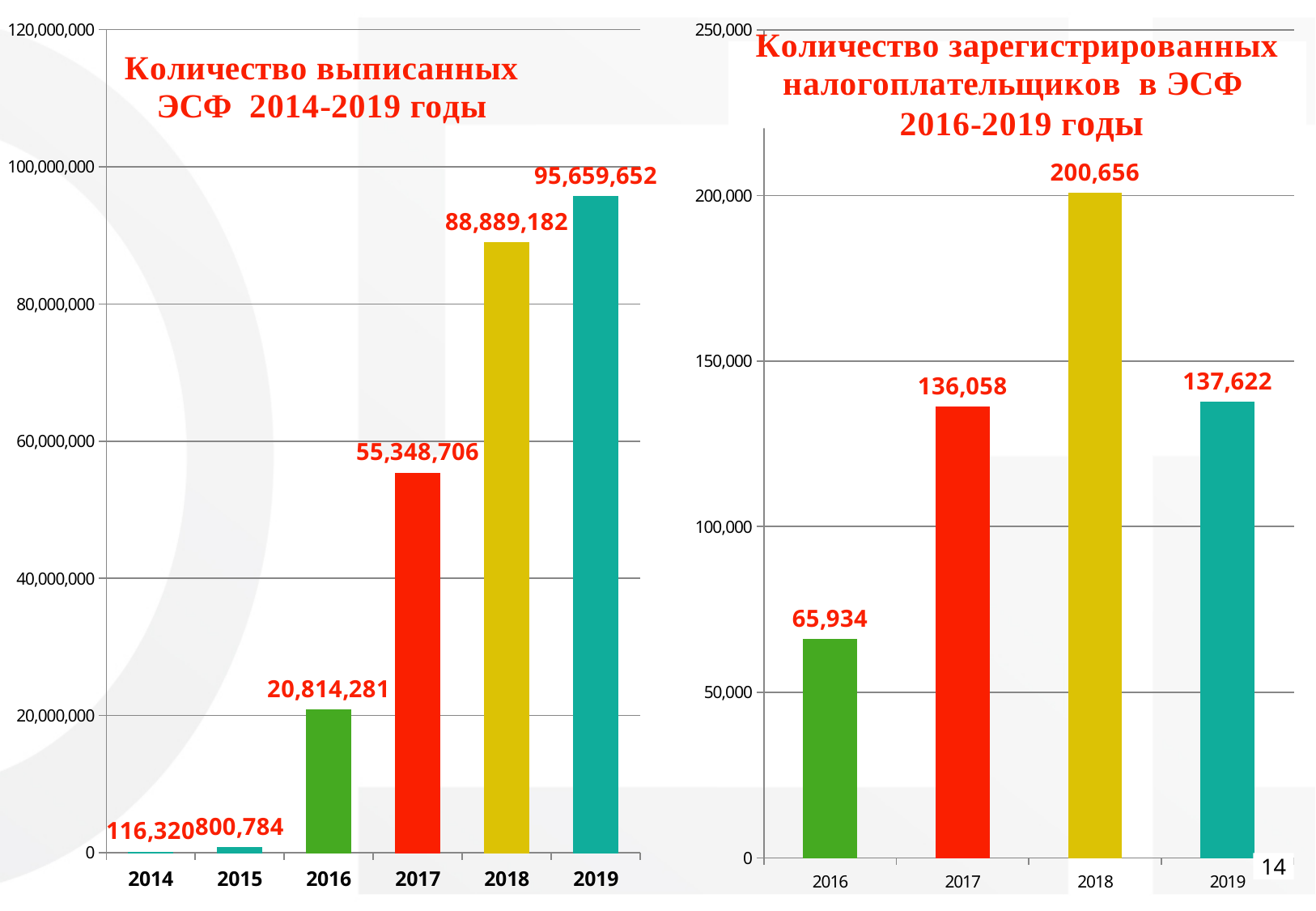
In the right chart (Количество зарегистрированных налогоплательщиков в ЭСФ 2016-2019 годы), what is the value for 2018? 200,656 In the left chart (Количество выписанных ЭСФ 2014-2019 годы), what is the value for 2019? 95,659,652 In the left chart (Количество выписанных ЭСФ 2014-2019 годы), which year has the lowest value? 2014 In the left chart (Количество выписанных ЭСФ 2014-2019 годы), how many years are shown on the x axis? 6 In the left chart (Количество выписанных ЭСФ 2014-2019 годы), do the values rise or fall from 2014 to 2019? rise In the right chart (Количество зарегистрированных налогоплательщиков в ЭСФ 2016-2019 годы), which year has the highest value? 2018 In the left chart (Количество выписанных ЭСФ 2014-2019 годы), what is the difference between the 2019 and 2018 values? 6,770,470 In the right chart (Количество зарегистрированных налогоплательщиков в ЭСФ 2016-2019 годы), which is larger: the value for 2017 or the value for 2016? 2017 What kind of chart is the right chart (Количество зарегистрированных налогоплательщиков в ЭСФ 2016-2019 годы)? bar chart In the left chart (Количество выписанных ЭСФ 2014-2019 годы), what is the value for 2016? 20,814,281 In the right chart (Количество зарегистрированных налогоплательщиков в ЭСФ 2016-2019 годы), what is the difference between the 2018 and 2019 values? 63,034 In the right chart (Количество зарегистрированных налогоплательщиков в ЭСФ 2016-2019 годы), is the value for 2016 greater or less than 100,000? less